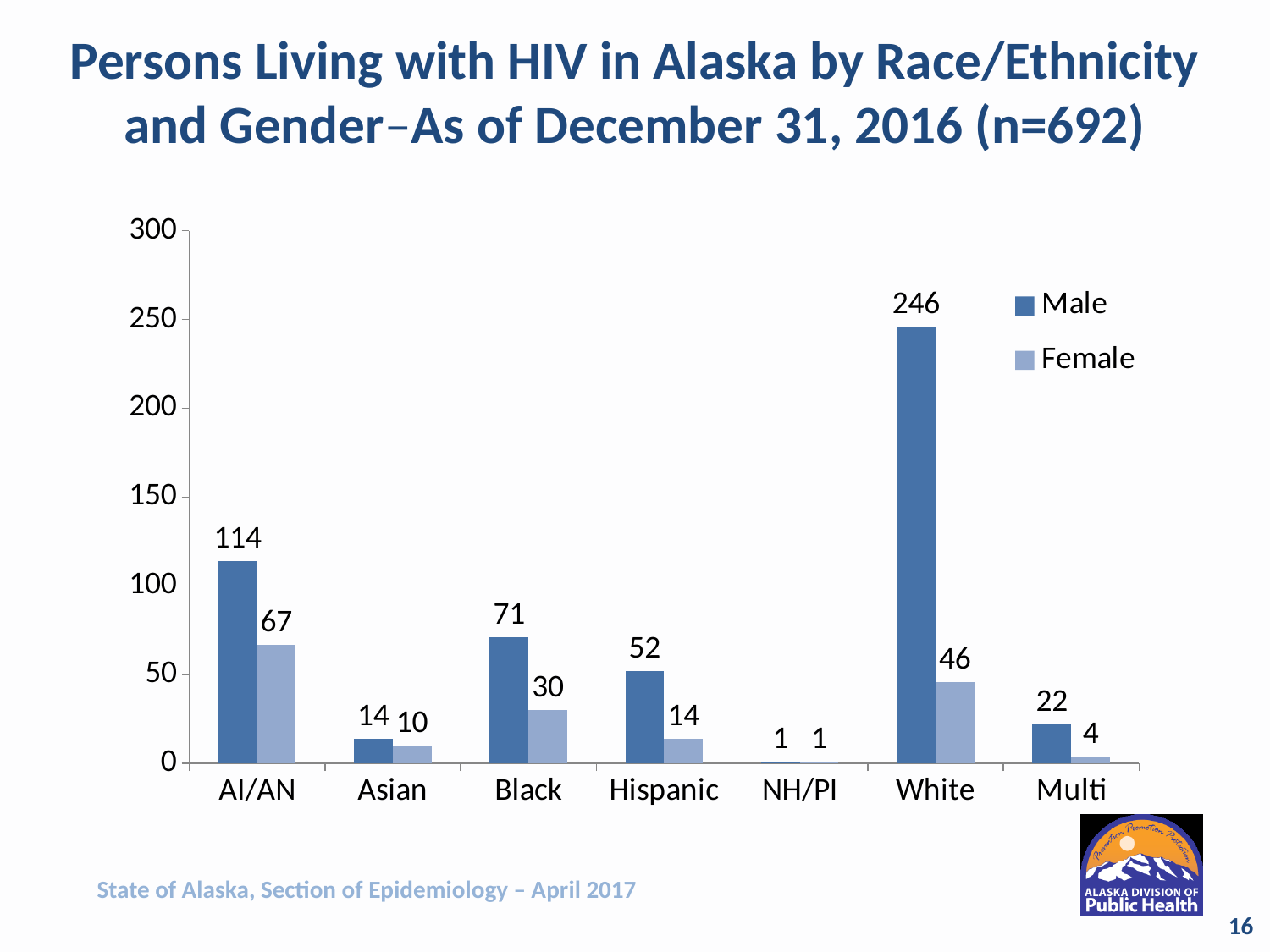
What is the Female value for AI/AN? 67 What is the Female value for Black? 30 Which race/ethnicity category has the highest Male value? White What is the Male value for White? 246 What is the difference between the Male values for AI/AN and Black? 43 How many race/ethnicity categories are shown on the x axis? 7 Which is larger, the Female value for Hispanic or the Female value for Asian? Hispanic Which race/ethnicity category has the lowest Female value? NH/PI How many series does the legend list? 2 What is the difference between the Male and Female values for White? 200 Which series is shown in the darker blue colour? Male What kind of chart is shown on the slide? Bar chart